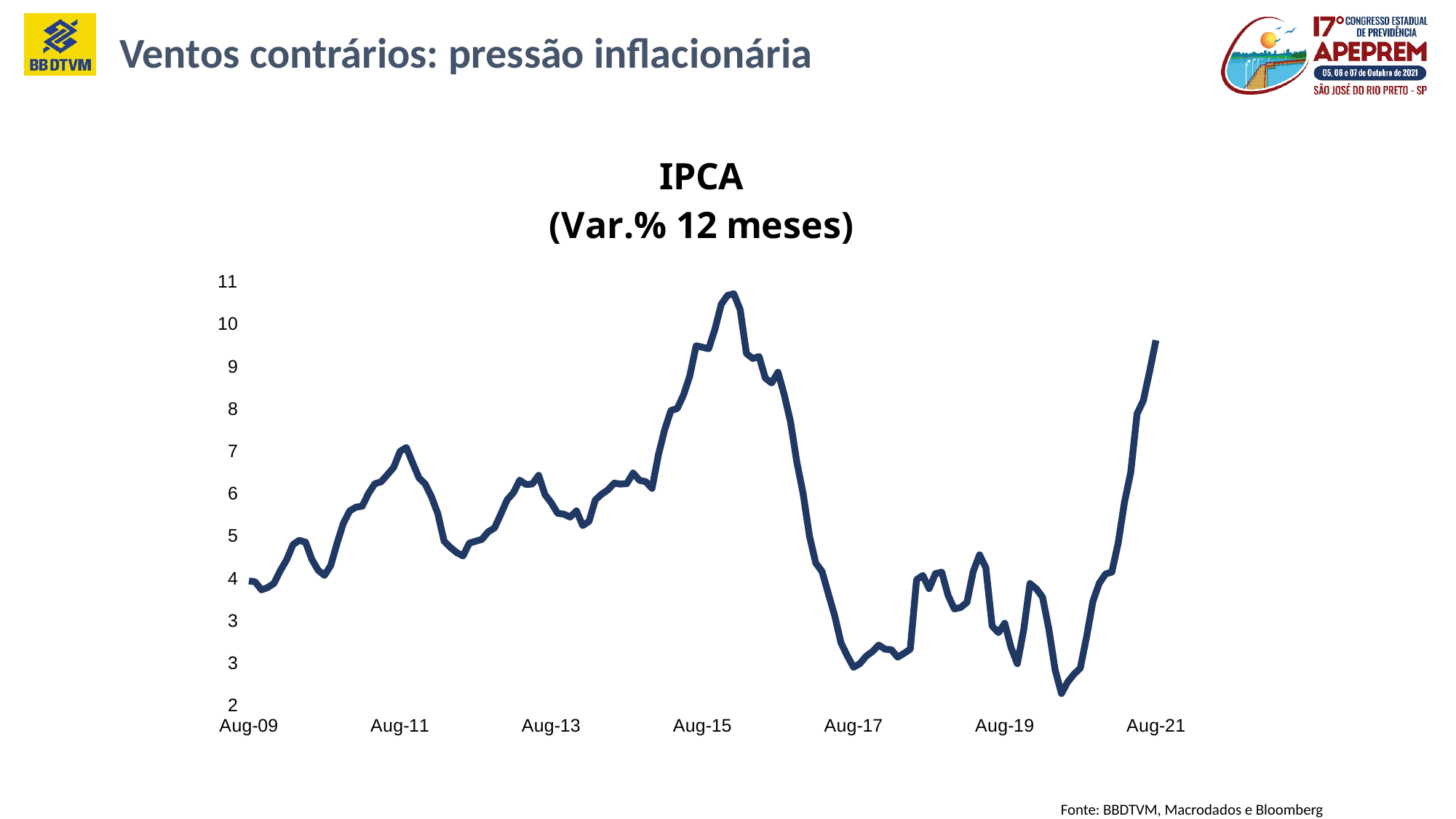
Between which two x-axis labels does the IPCA line reach its highest point? Aug-15 and Aug-17 Between Aug-19 and Aug-21, does the IPCA line overall rise or fall? rise What is the title of the chart? IPCA (Var.% 12 meses) Which is larger, the IPCA value at Aug-21 or at Aug-17? Aug-21 Is the peak value of the IPCA line greater or less than 10? greater Is the lowest value of the IPCA line greater or less than 3? less Is the value of the IPCA line at Aug-17 greater or less than 4? less How many date labels are shown on the x axis of the chart? 7 What kind of chart is shown on the slide? line chart